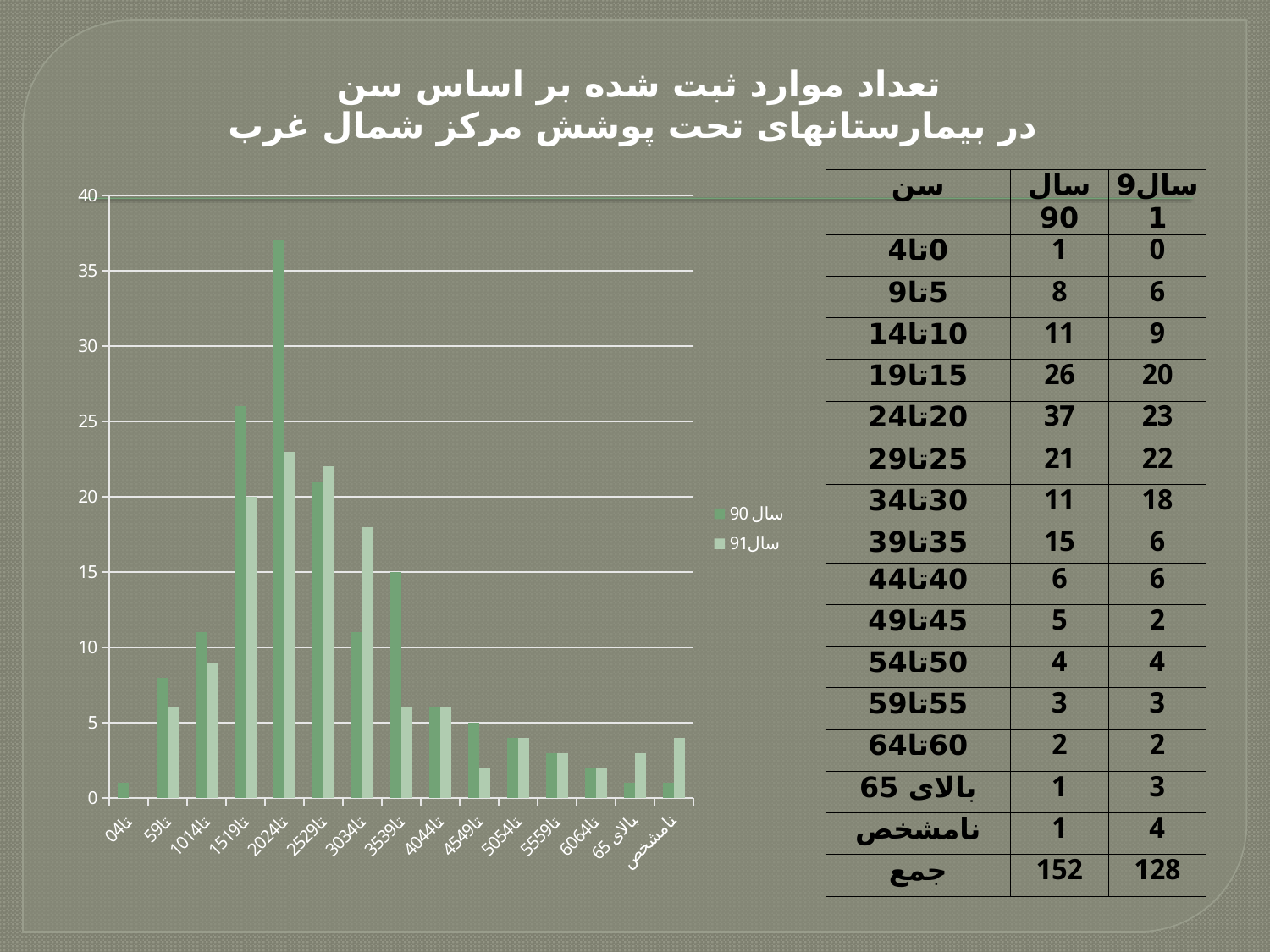
Which age category has the highest value for سال 90? 20تا24 What is the value for سال91 in the 30تا34 age category? 18 What is the difference between سال 90 and سال91 in the 20تا24 category? 14 Is the value for سال 90 in the 15تا19 category greater or less than 25? greater What is the value for سال 90 in the 20تا24 age category? 37 How many series does the chart legend list? 2 How many age categories are plotted along the x axis of the chart? 15 What kind of chart is shown on the slide? bar chart Which age category has the highest value for سال91? 20تا24 Is the value for سال91 in the 25تا29 category greater or less than 20? greater Which is larger in the 35تا39 category, سال 90 or سال91? سال 90 What are the two series names shown in the chart legend? سال 90 and سال91